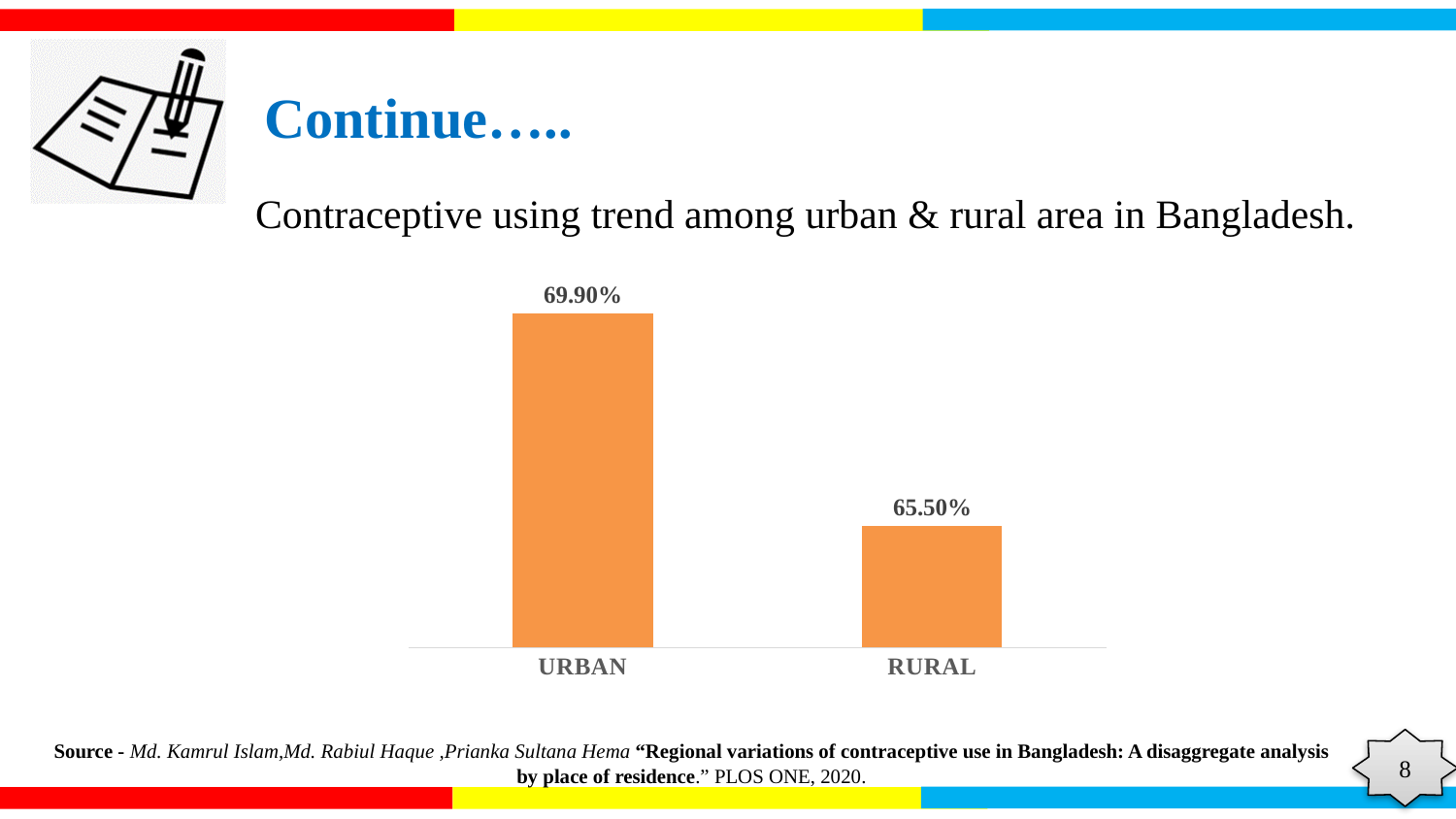
What is the contraceptive use value for URBAN? 69.90% What is the contraceptive use value for RURAL? 65.50% Do the values rise or fall from URBAN to RURAL? fall Is the value for URBAN larger or smaller than the value for RURAL? larger What colour are the bars in the chart? orange What kind of chart is shown on the slide? bar chart What is the difference between the URBAN and RURAL values? 4.40% Which area has the higher contraceptive use value? URBAN What does the text above the chart say the chart is about? Contraceptive using trend among urban & rural area in Bangladesh. Which area has the lower contraceptive use value? RURAL How many categories are shown in the chart? 2